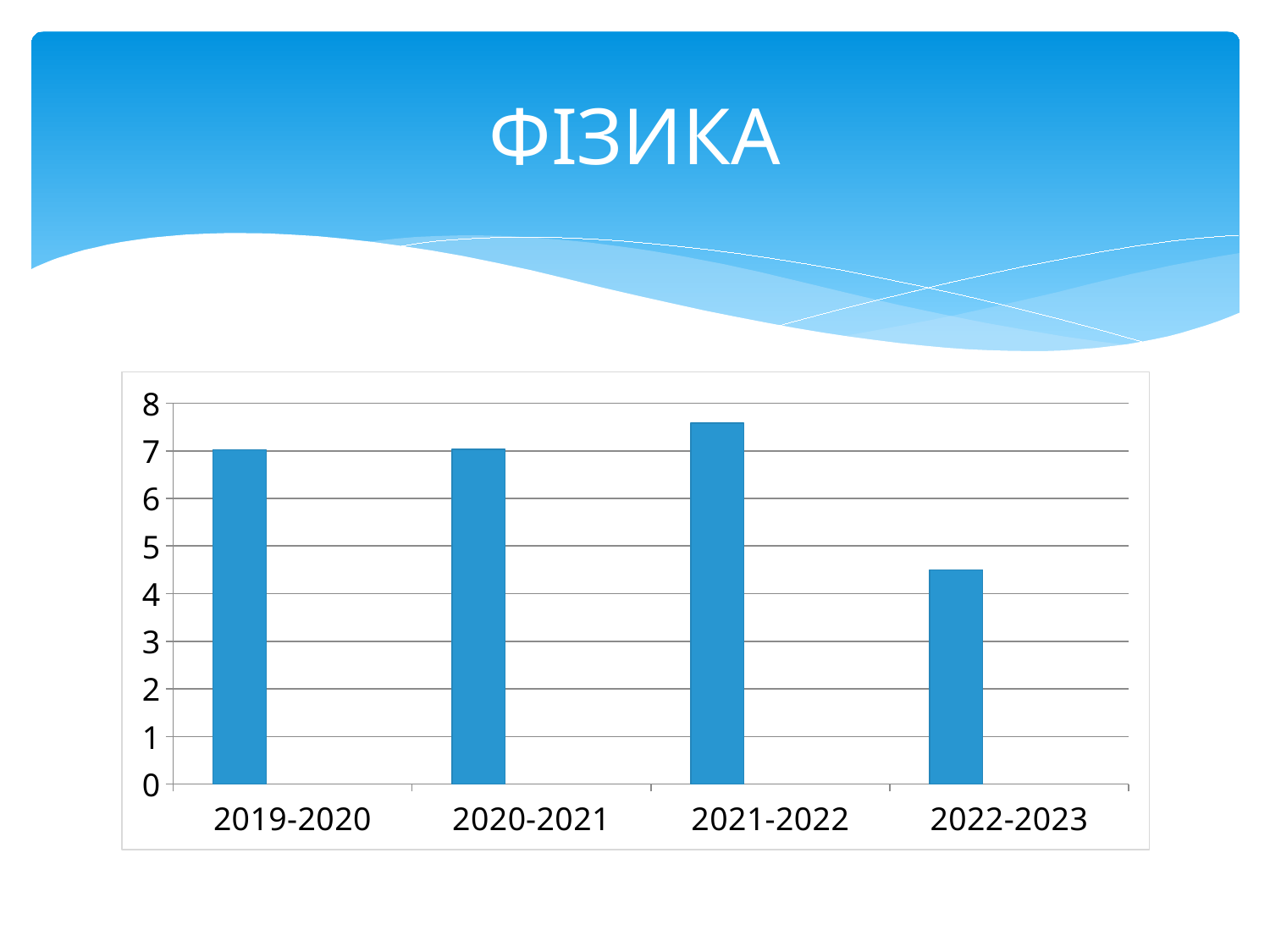
Is the value for 2022-2023 greater or less than 4? greater Does the value rise or fall from 2021-2022 to 2022-2023? fall Which is larger, the value for 2021-2022 or the value for 2022-2023? 2021-2022 Which school year has the lowest bar? 2022-2023 Which is larger, the value for 2019-2020 or the value for 2022-2023? 2019-2020 Is the value for 2022-2023 greater or less than 5? less Which school year has the highest bar? 2021-2022 Is the value for 2021-2022 greater or less than 7? greater What kind of chart is shown on the slide? bar chart How many categories (school years) are shown on the x axis? 4 What colour are the bars in the chart? blue